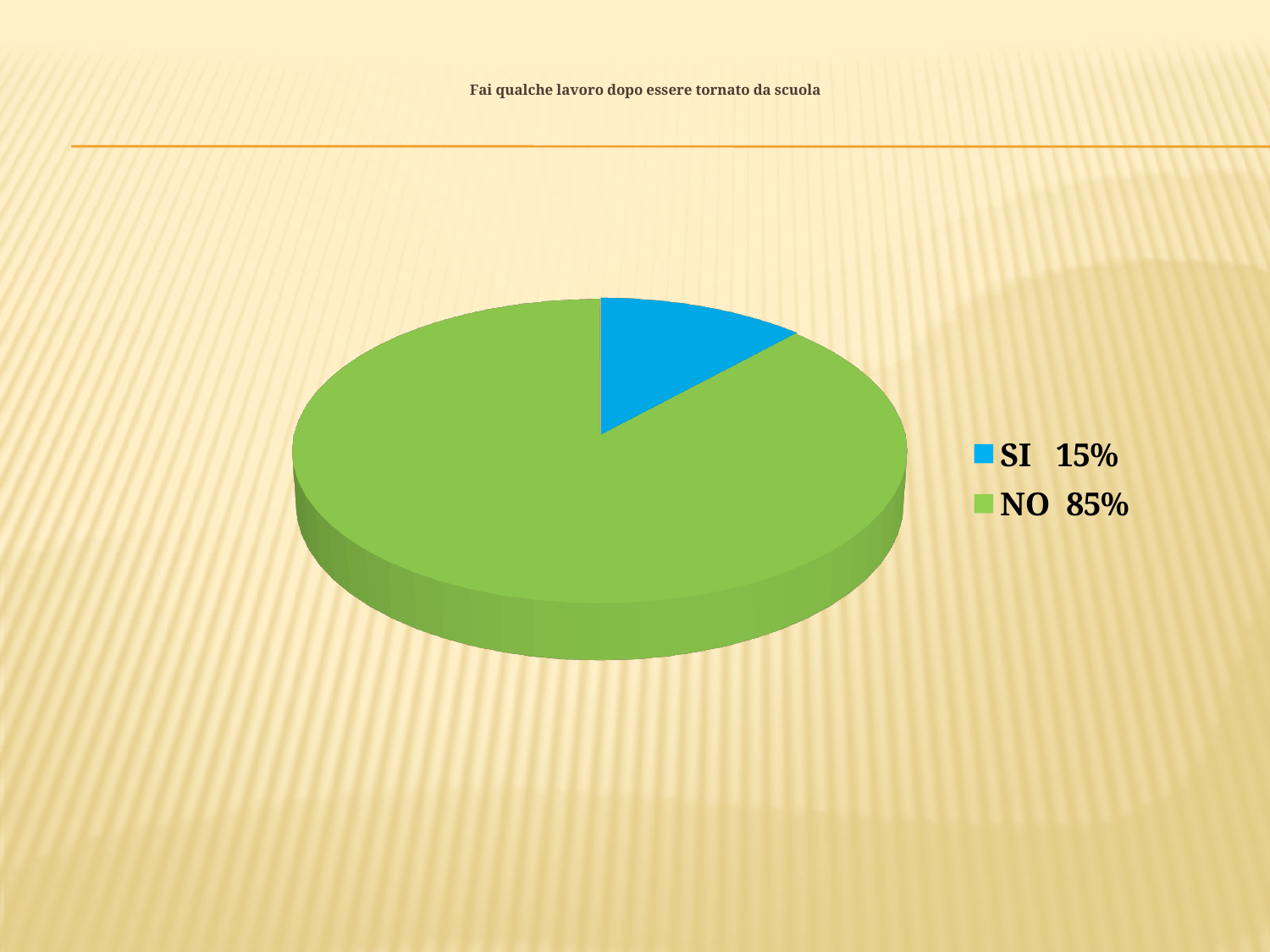
What kind of chart is shown on the slide? pie chart Which category has the smallest share of the pie? SI How many categories does the pie chart have? 2 What is the title of the slide above the chart? Fai qualche lavoro dopo essere tornato da scuola How many entries does the legend list? 2 What percentage is shown for SI? 15% What share of the pie does the NO slice represent? 85% What percentage is shown for NO? 85% Which is larger, the share for SI or the share for NO? NO Which category has the largest share of the pie? NO What is the difference in percentage points between NO and SI? 70 What colour is the slice for SI? blue